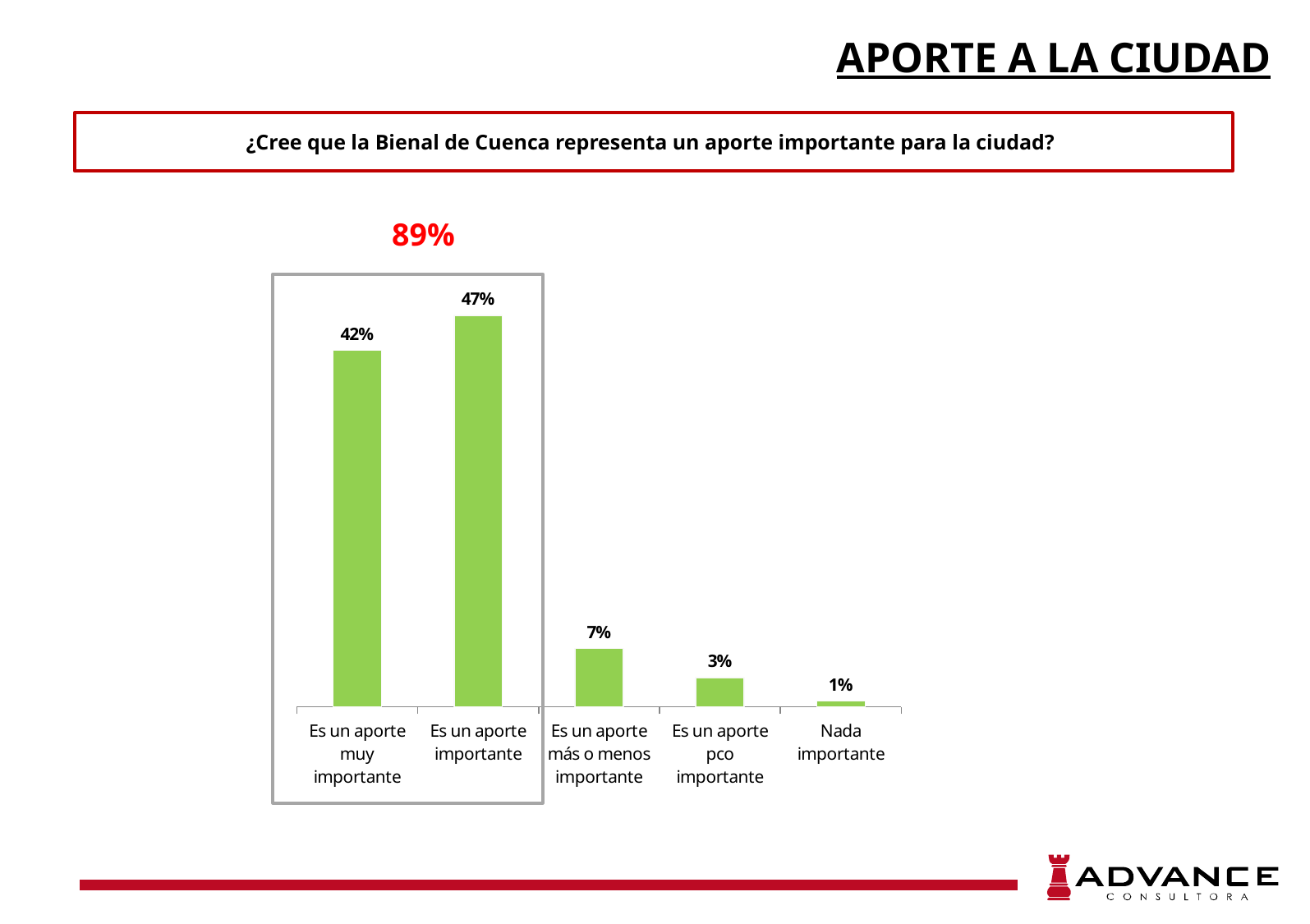
Which category has the lowest value? Nada importante Which is larger: "Es un aporte pco importante" or "Es un aporte más o menos importante"? Es un aporte más o menos importante How many categories are shown on the x axis? 5 What percentage is shown for "Es un aporte más o menos importante"? 7% What kind of chart is shown on the slide? Bar chart What combined percentage is highlighted in red above the boxed first two bars? 89% What value is shown for "Nada importante"? 1% Do the values rise or fall from left to right after the second bar? Fall What is the difference between "Es un aporte importante" and "Es un aporte muy importante"? 5% What percentage of respondents said the Bienal de Cuenca is "Es un aporte muy importante"? 42% What value is shown for "Es un aporte importante"? 47% Which category has the highest value? Es un aporte importante